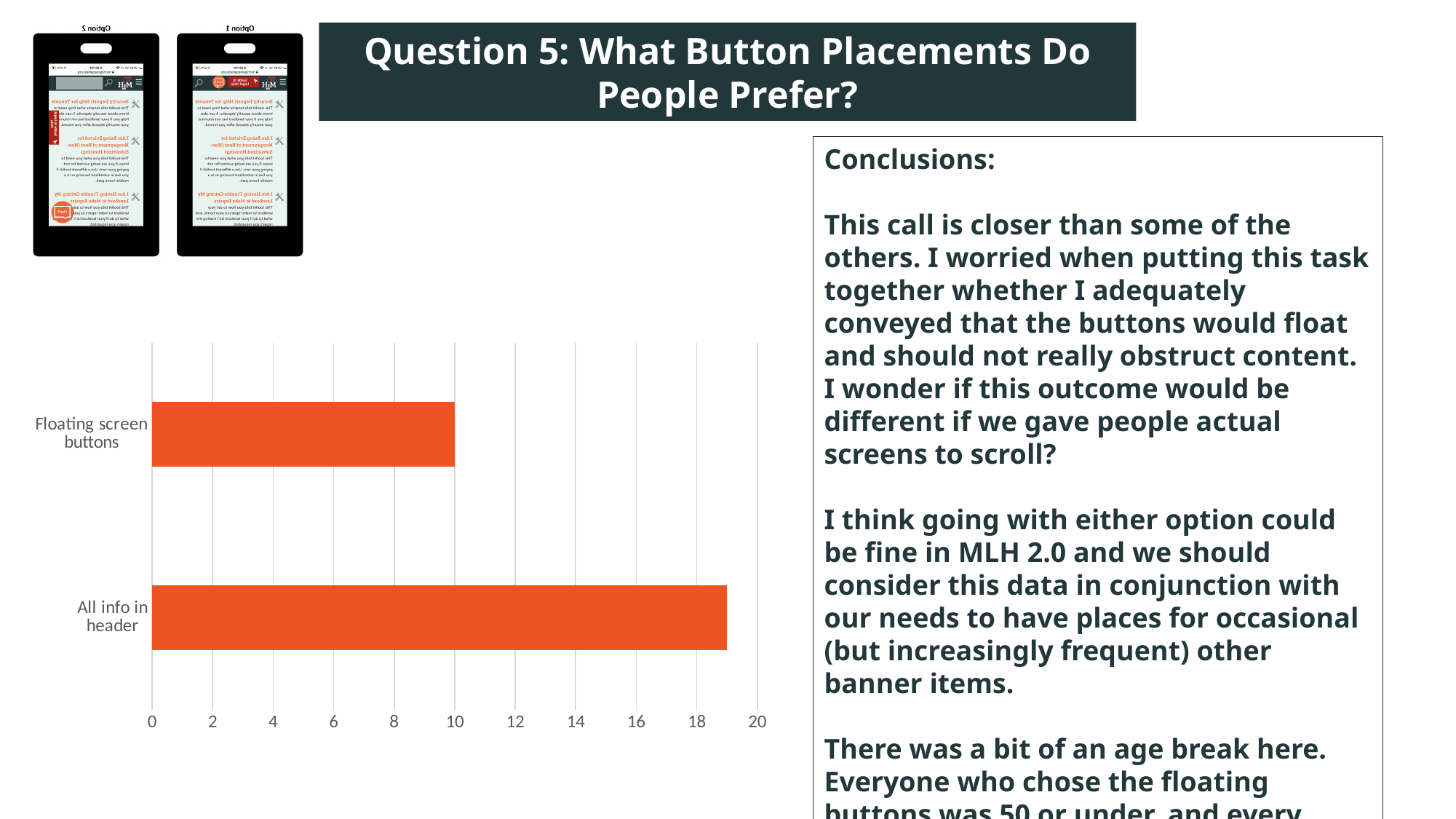
What is the value for Floating screen buttons? 10 What type of chart is shown on the slide? bar chart Which is larger, the value for All info in header or the value for Floating screen buttons? All info in header Which category has the lowest value? Floating screen buttons What colour are the bars in the chart? orange What is the maximum value shown on the horizontal axis? 20 Which category has the highest value? All info in header Is the value for Floating screen buttons greater or less than 12? less How many categories does the bar chart show? 2 Is the value for All info in header greater or less than 20? less Is the value for All info in header greater or less than 18? greater